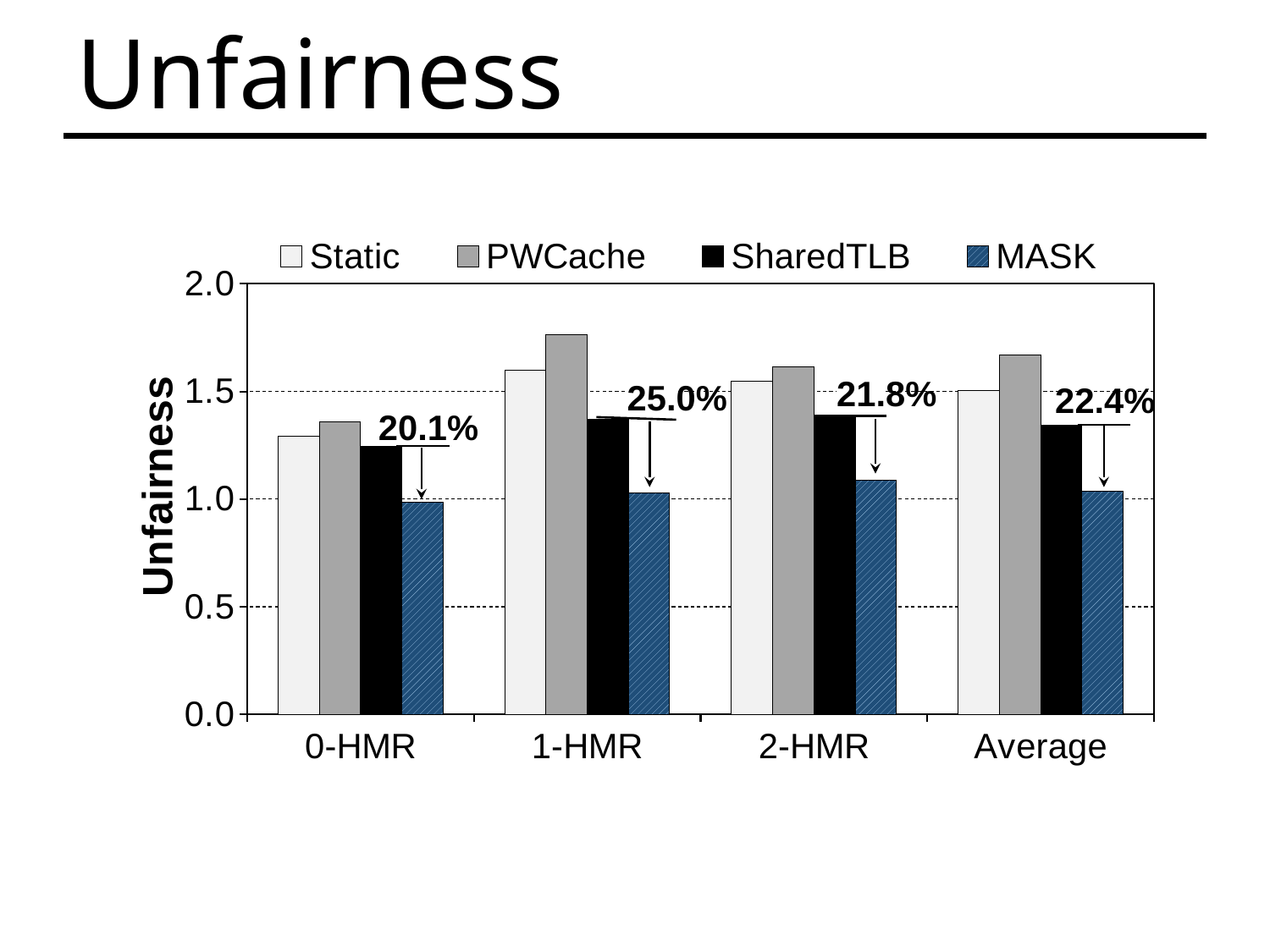
Which series has the highest bar in the 1-HMR category? PWCache Is the Static value for 0-HMR greater or less than 1.5? less What percentage reduction is annotated above the MASK bar for 1-HMR? 25.0% What is the label of the y axis? Unfairness What percentage reduction is annotated above the MASK bar for Average? 22.4% Which is larger in the 2-HMR category, the Static bar or the MASK bar? Static Is the PWCache value for 1-HMR greater or less than 1.5? greater What kind of chart is shown on the slide? bar chart How many series does the legend list? 4 How many categories are shown on the x axis? 4 Which series has the lowest bar in the Average category? MASK